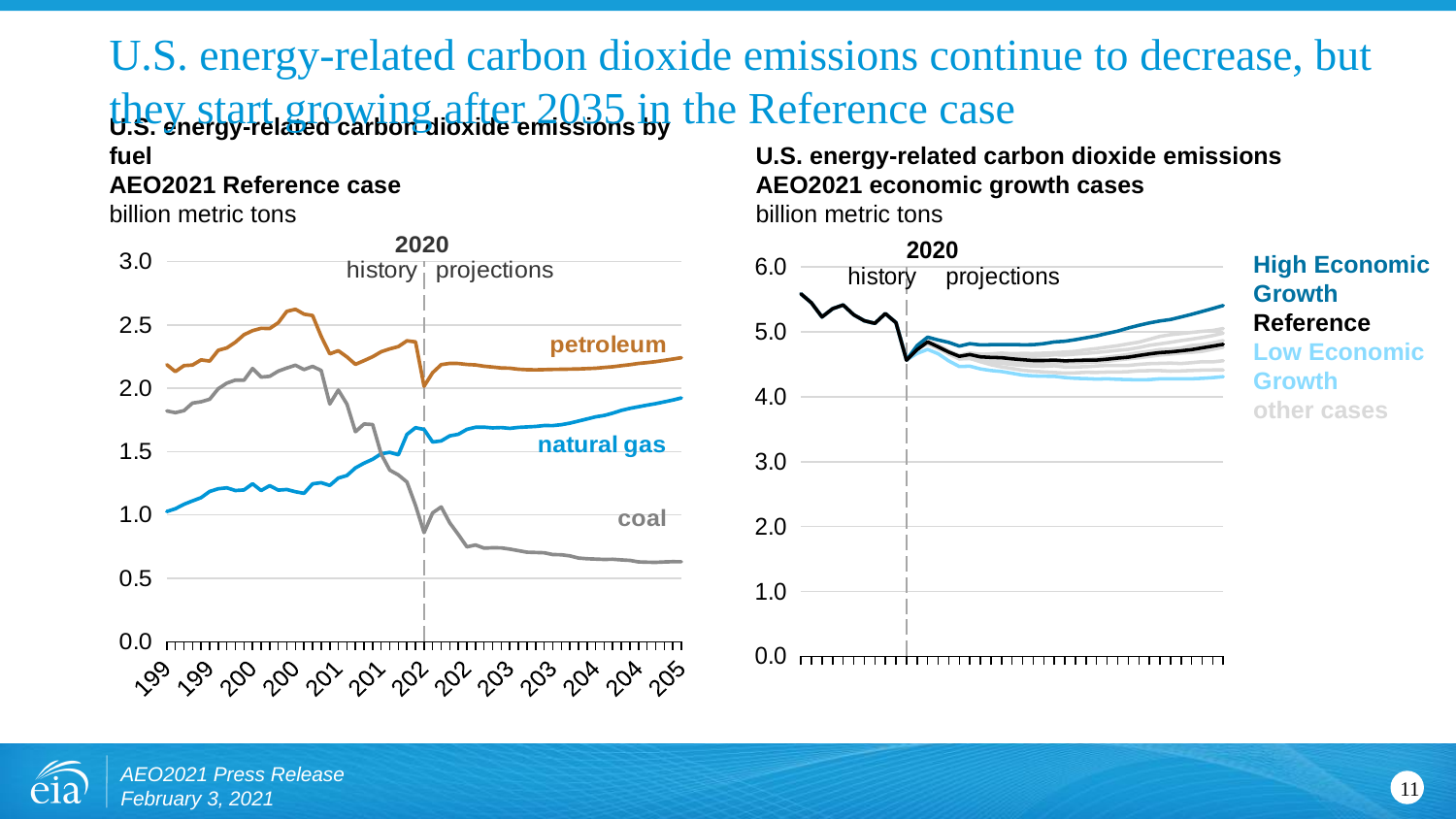
In the right chart (economic growth cases), is the value for Low Economic Growth at the end of the projection period greater or less than 5.0? less In the left chart (emissions by fuel), which is larger at the end of the projection period, petroleum or coal? petroleum In the left chart (emissions by fuel), does the coal line rise or fall over the period shown? fall In the left chart (emissions by fuel), is the value for coal at the end of the projection period greater or less than 1.0? less In the left chart (emissions by fuel), how many fuel series are labeled? 3 In the right chart (economic growth cases), which is larger at the end of the projection period, High Economic Growth or Low Economic Growth? High Economic Growth In the left chart (emissions by fuel), is the value for petroleum at the end of the projection period greater or less than 2.0? greater What unit of measurement is shown for both charts? billion metric tons In the right chart (economic growth cases), how many entries does the legend list? 4 What type of chart is the left chart, 'U.S. energy-related carbon dioxide emissions by fuel'? line chart